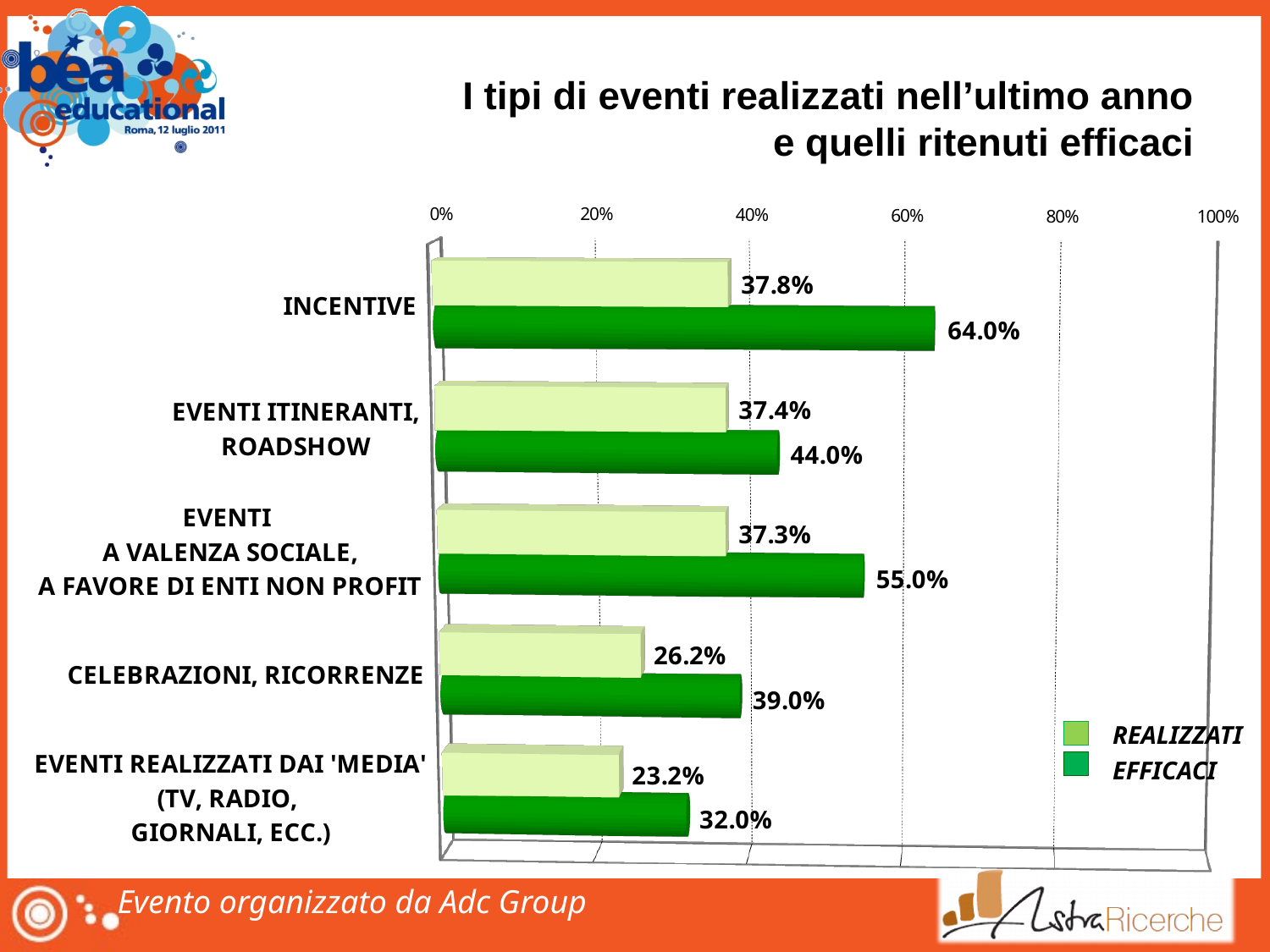
What kind of chart is shown on the slide? Bar chart How many categories are shown in the chart? 5 Which category has the lowest REALIZZATI value? EVENTI REALIZZATI DAI 'MEDIA' (TV, RADIO, GIORNALI, ECC.) What is the REALIZZATI value for INCENTIVE? 37.8% How many series does the legend list? 2 What is the difference between the EFFICACI and REALIZZATI values for INCENTIVE? 26.2% Is the EFFICACI value for EVENTI A VALENZA SOCIALE, A FAVORE DI ENTI NON PROFIT greater or less than 40%? greater Which is larger for EVENTI ITINERANTI, ROADSHOW: the REALIZZATI value or the EFFICACI value? EFFICACI What is the EFFICACI value for CELEBRAZIONI, RICORRENZE? 39.0% What is the REALIZZATI value for EVENTI REALIZZATI DAI 'MEDIA' (TV, RADIO, GIORNALI, ECC.)? 23.2% Which category has the highest EFFICACI value? INCENTIVE What is the EFFICACI value for INCENTIVE? 64.0%